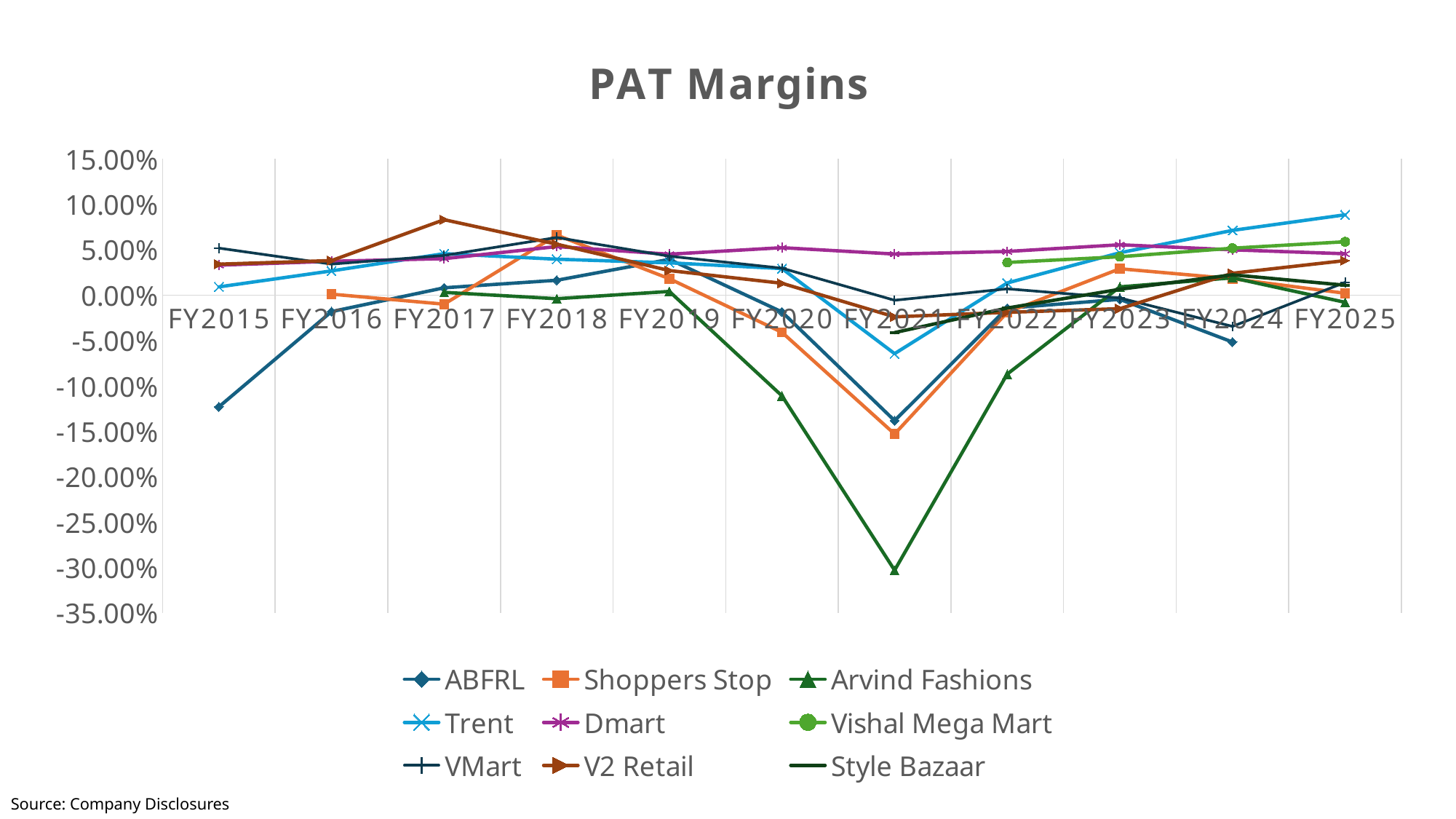
Which is larger in FY2021, the value for Shoppers Stop or the value for Arvind Fashions? Shoppers Stop Which series has the highest PAT margin in FY2025? Trent What source is cited at the bottom of the slide? Company Disclosures What is the title of the chart? PAT Margins What kind of chart is shown on the slide? line chart Which series has the lowest PAT margin in FY2021? Arvind Fashions Is the value for Trent in FY2025 greater or less than 5.00%? greater How many series does the legend list? 9 Does the Trent line rise or fall from FY2021 to FY2025? rise Is the value for ABFRL in FY2015 greater or less than -10.00%? less How many fiscal years are shown on the x axis? 11 Is the value for Arvind Fashions in FY2021 greater or less than -25.00%? less